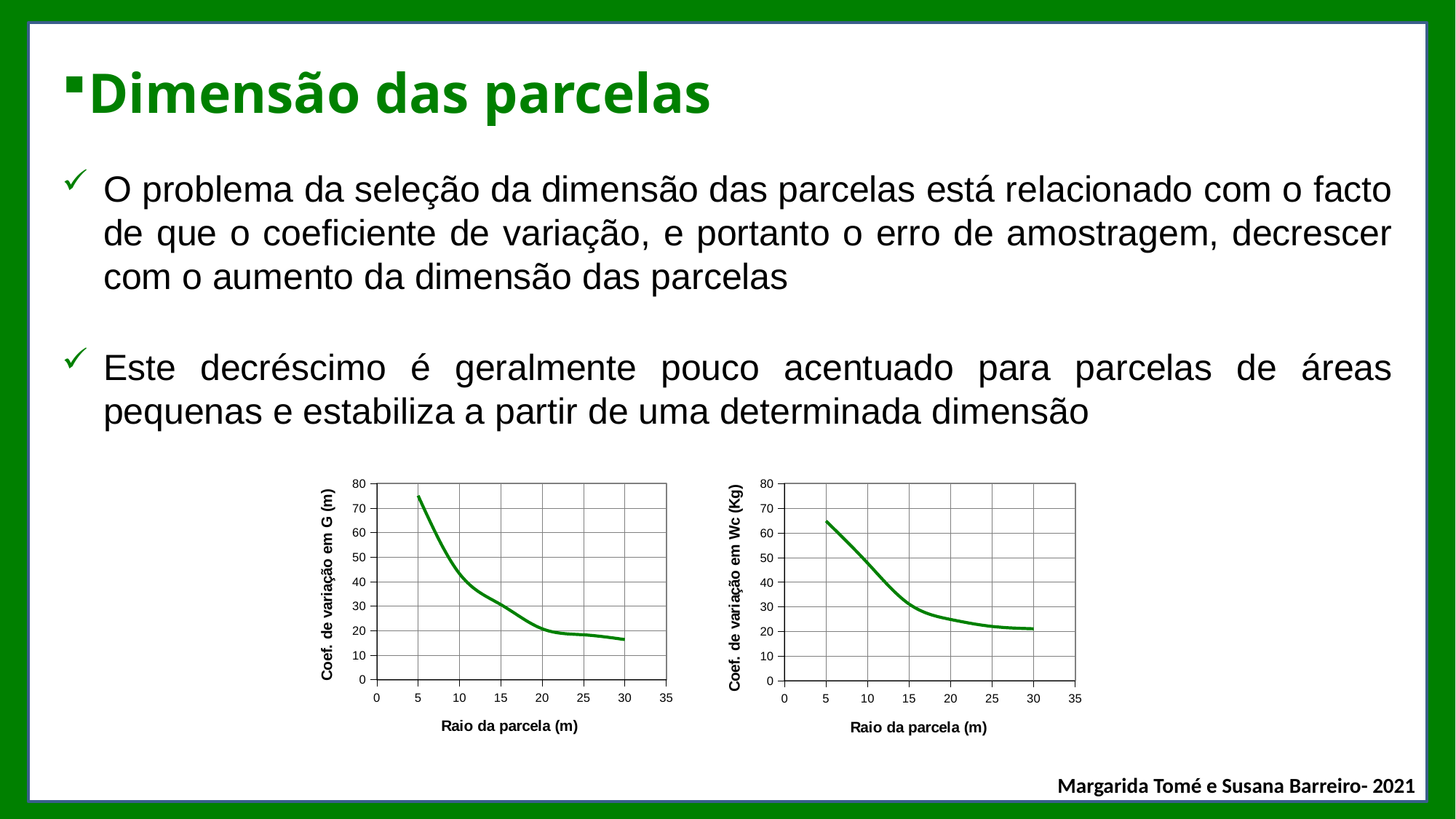
In the left chart (Coef. de variação em G), do the values rise or fall as the plot radius increases? fall In the right chart (Coef. de variação em Wc), is the value at a radius of 5 m greater or less than 60? greater In the left chart (Coef. de variação em G), is the value at a radius of 30 m greater or less than 20? less In the right chart (Coef. de variação em Wc), do the values rise or fall as the plot radius increases? fall At a radius of 5 m, which chart shows the higher coefficient of variation, the left chart (G) or the right chart (Wc)? the left chart (G) How many charts are shown on the slide? 2 What is the x-axis label of the left chart? Raio da parcela (m) What is the y-axis label of the right chart? Coef. de variação em Wc (Kg) In the left chart (Coef. de variação em G), is the value at a radius of 5 m greater or less than 70? greater In the left chart (Coef. de variação em G), which radius has the higher value, 5 m or 30 m? 5 m What kind of chart is the left chart on the slide? line chart